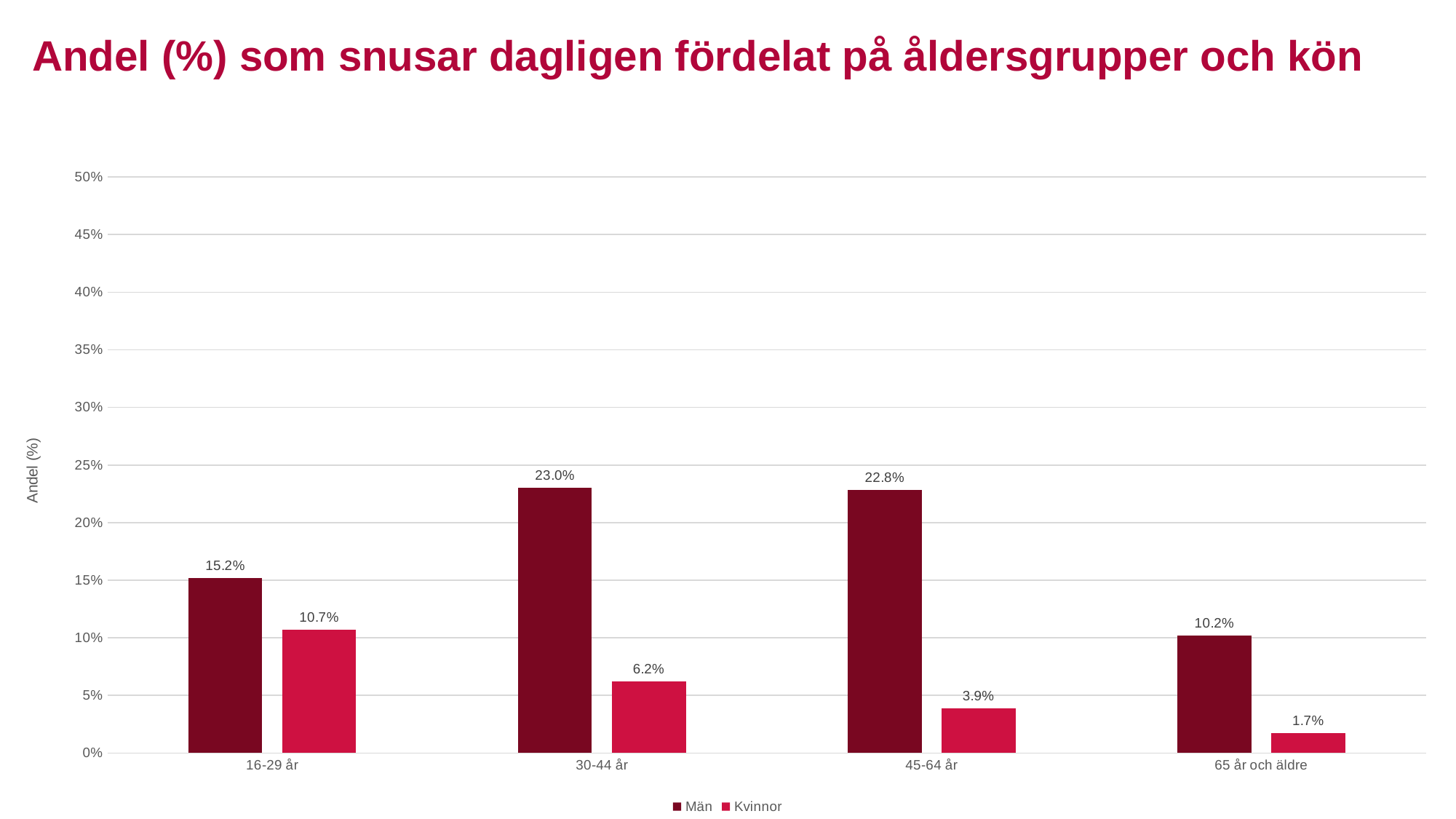
How many age groups are shown on the x axis? 4 What is the difference between the Män and Kvinnor values in the 45-64 år age group? 18.9% What is the value for Kvinnor in the 16-29 år age group? 10.7% Do the Kvinnor values rise or fall from the youngest to the oldest age group? Fall What kind of chart is shown on the slide? Bar chart What is the label of the y axis? Andel (%) What is the value for Män in the 30-44 år age group? 23.0% Which is larger: the Män value for 16-29 år or the Kvinnor value for 16-29 år? Män How many series does the legend list? 2 Which age group has the lowest value for Män? 65 år och äldre What is the value for Kvinnor in the 65 år och äldre age group? 1.7% Which age group has the highest value for Kvinnor? 16-29 år